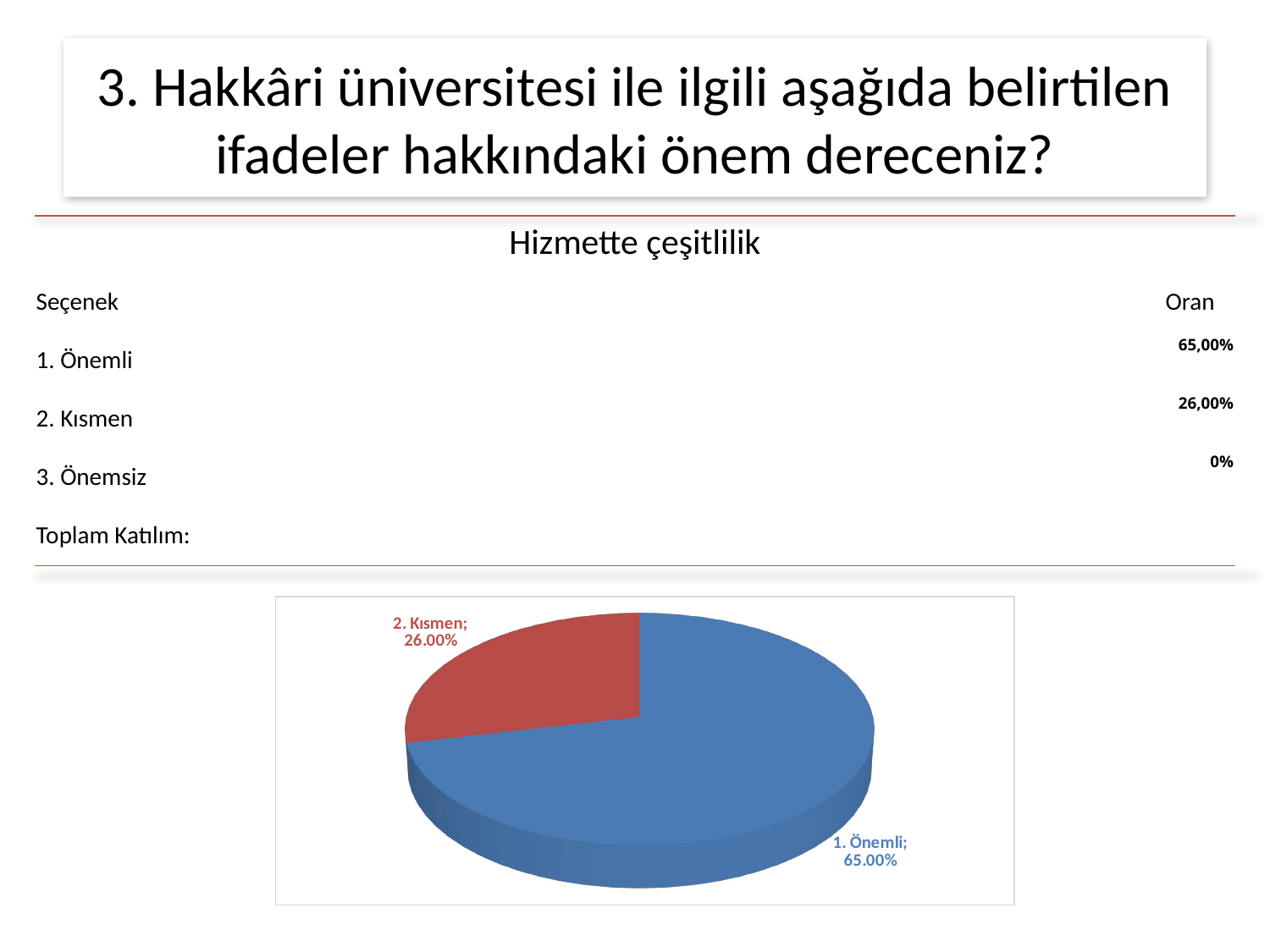
By how many percentage points does the "1. Önemli" slice exceed the "2. Kısmen" slice in the pie chart? 39.00 percentage points What colour is the "1. Önemli" slice in the pie chart? Blue Is the share for "1. Önemli" in the pie chart greater or less than 50%? greater What share of the pie chart does the slice labelled "2. Kısmen" represent? 26.00% What colour is the "2. Kısmen" slice in the pie chart? Red Which slice of the pie chart is the largest? 1. Önemli What share of the pie chart does the slice labelled "1. Önemli" represent? 65.00% Is the share for "2. Kısmen" in the pie chart greater or less than 50%? less Which is larger in the pie chart, the share for "1. Önemli" or the share for "2. Kısmen"? 1. Önemli Which labelled slice of the pie chart is the smallest? 2. Kısmen How many labelled slices does the pie chart show? 2 What kind of chart is shown on the slide? Pie chart